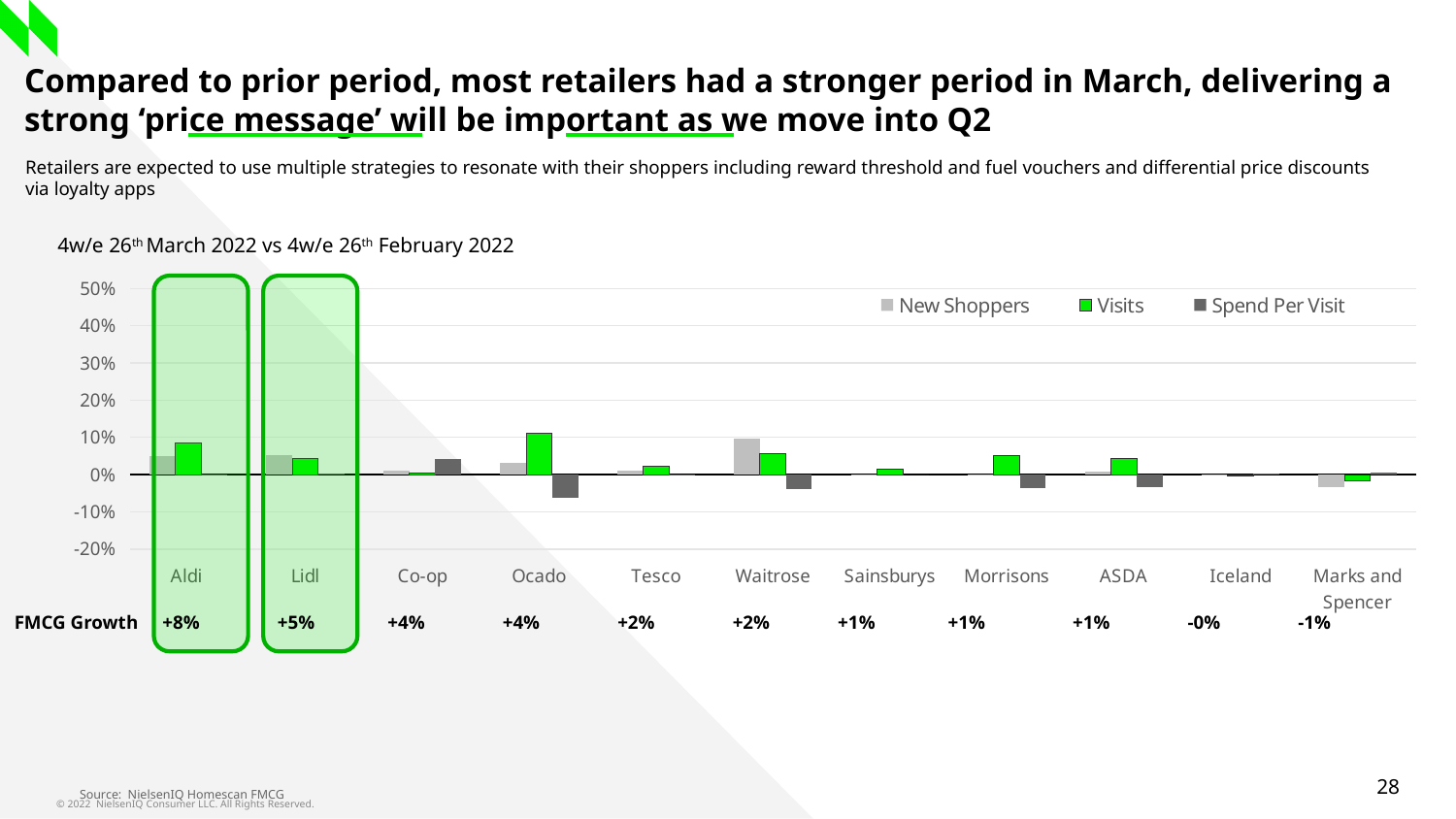
Which retailer has the tallest New Shoppers bar? Waitrose Is the Visits bar for Aldi greater or less than 10%? less Which series is shown in bright green in the legend? Visits Which retailer has the tallest Visits bar? Ocado How many retailers are shown along the x axis of the chart? 11 Which retailer has the highest FMCG Growth value? Aldi How many series does the chart legend list? 3 What is the difference in FMCG Growth between Aldi and Lidl? 3 percentage points What is the FMCG Growth value shown for Iceland? -0% What is the FMCG Growth value shown for Aldi? +8% What kind of chart is shown on the slide? Bar chart What is the FMCG Growth value shown for Marks and Spencer? -1%